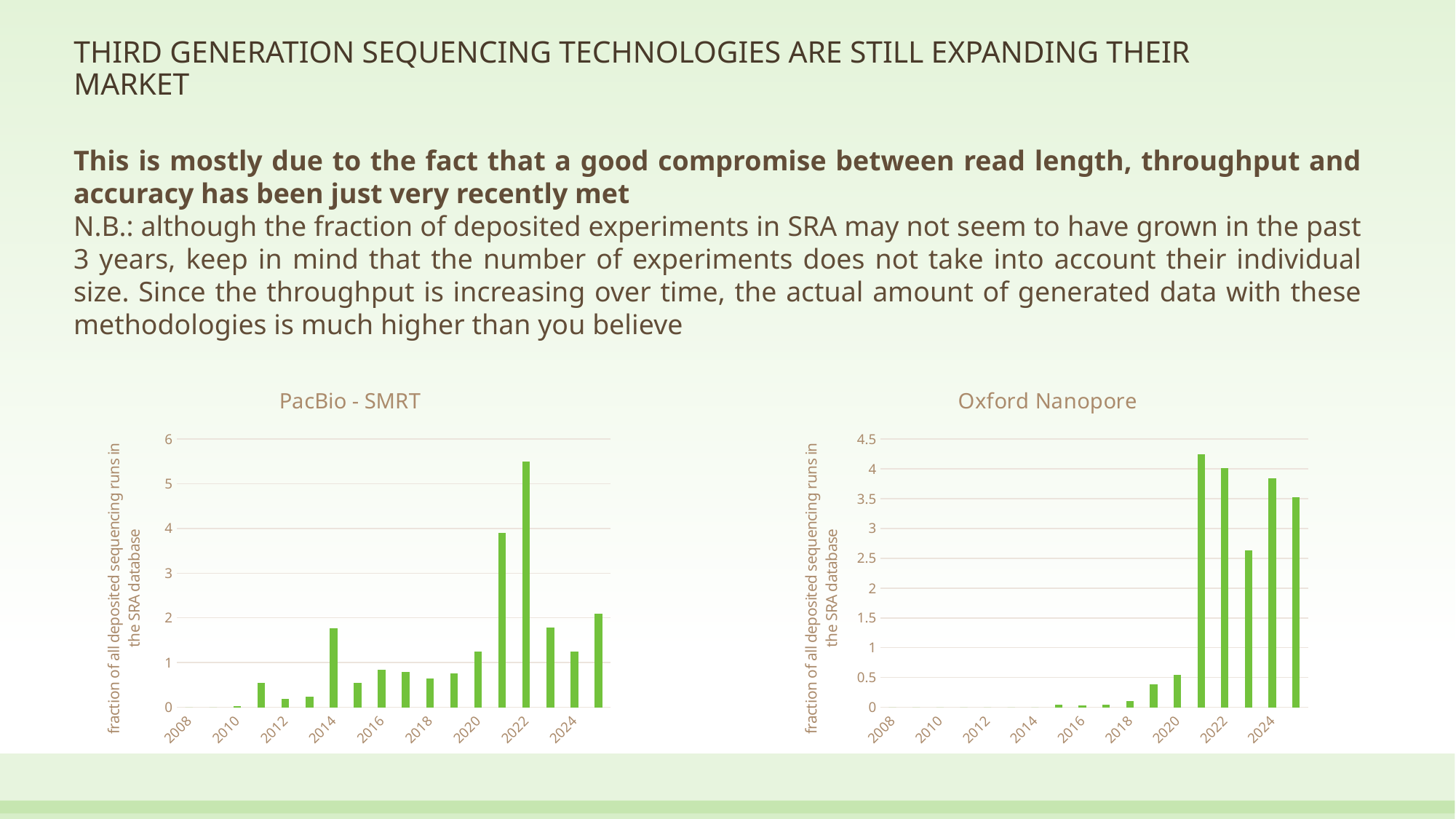
In the PacBio - SMRT chart, is the value for 2014 greater or less than 2? less What is the y-axis label of the PacBio - SMRT chart? fraction of all deposited sequencing runs in the SRA database In the PacBio - SMRT chart, is the value for 2022 greater or less than 5? greater In the Oxford Nanopore chart, is the value for 2023 greater or less than 3? less In the PacBio - SMRT chart, which is larger, the value for 2014 or the value for 2016? 2014 What kind of chart is the PacBio - SMRT chart? bar chart In the Oxford Nanopore chart, which is larger, the value for 2023 or the value for 2024? 2024 In the Oxford Nanopore chart, do the values rise or fall from 2018 to 2021? rise In the PacBio - SMRT chart, which year has the highest bar? 2022 What is the title of the chart on the right side of the slide? Oxford Nanopore